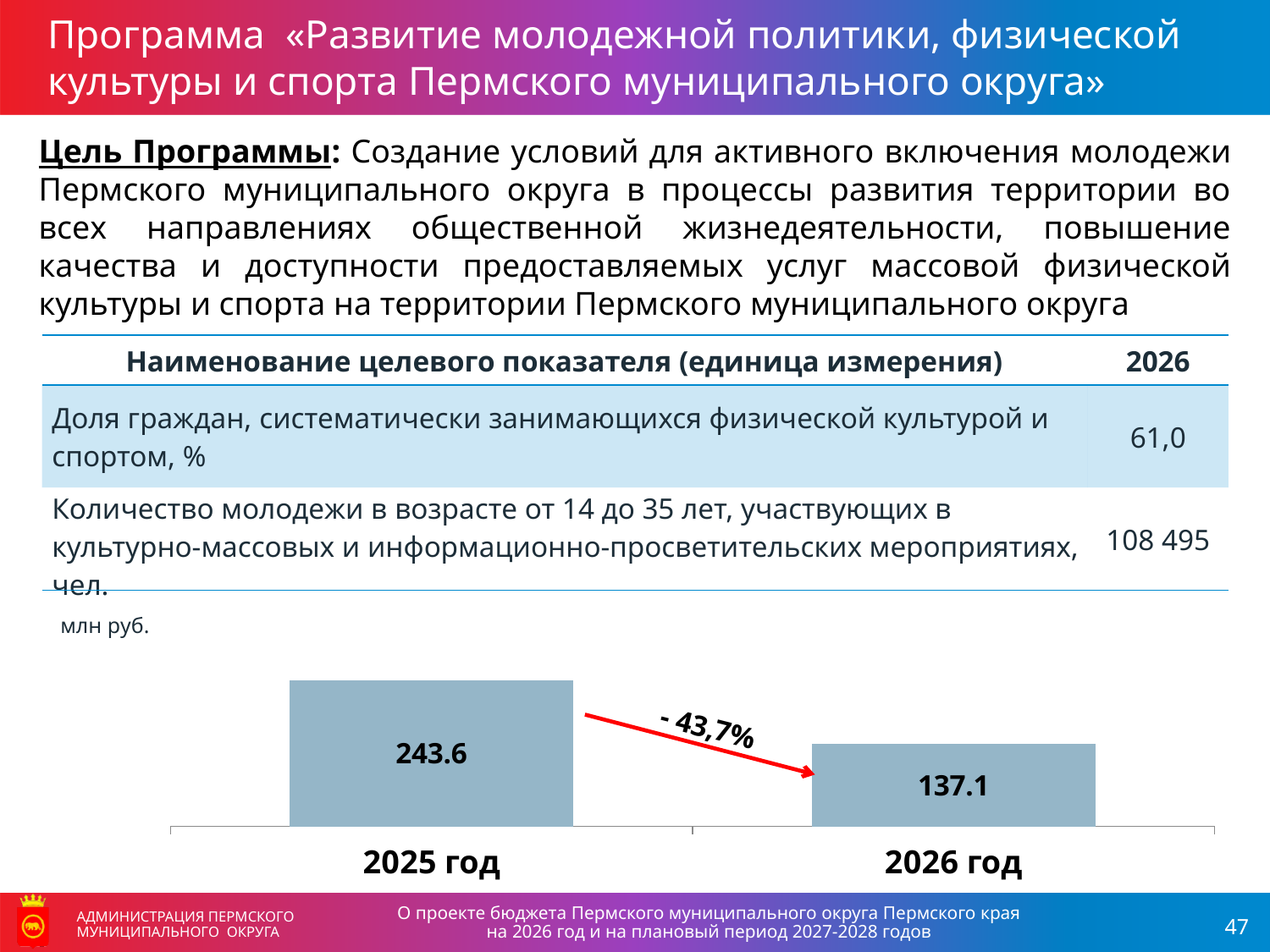
What unit of measurement is indicated above the bar chart? млн руб. Which year has the lower value in the bar chart? 2026 год What is the value shown for 2025 год in the bar chart? 243.6 What is the value shown for 2026 год in the bar chart? 137.1 What percentage change is written on the arrow between the two bars? - 43,7% Do the values rise or fall from 2025 год to 2026 год? fall Is the value for 2026 год larger or smaller than the value for 2025 год? smaller What is the difference between the values for 2025 год and 2026 год in the bar chart? 106.5 Which year has the higher value in the bar chart? 2025 год What type of chart is shown on the slide? bar chart How many bars are plotted in the chart? 2